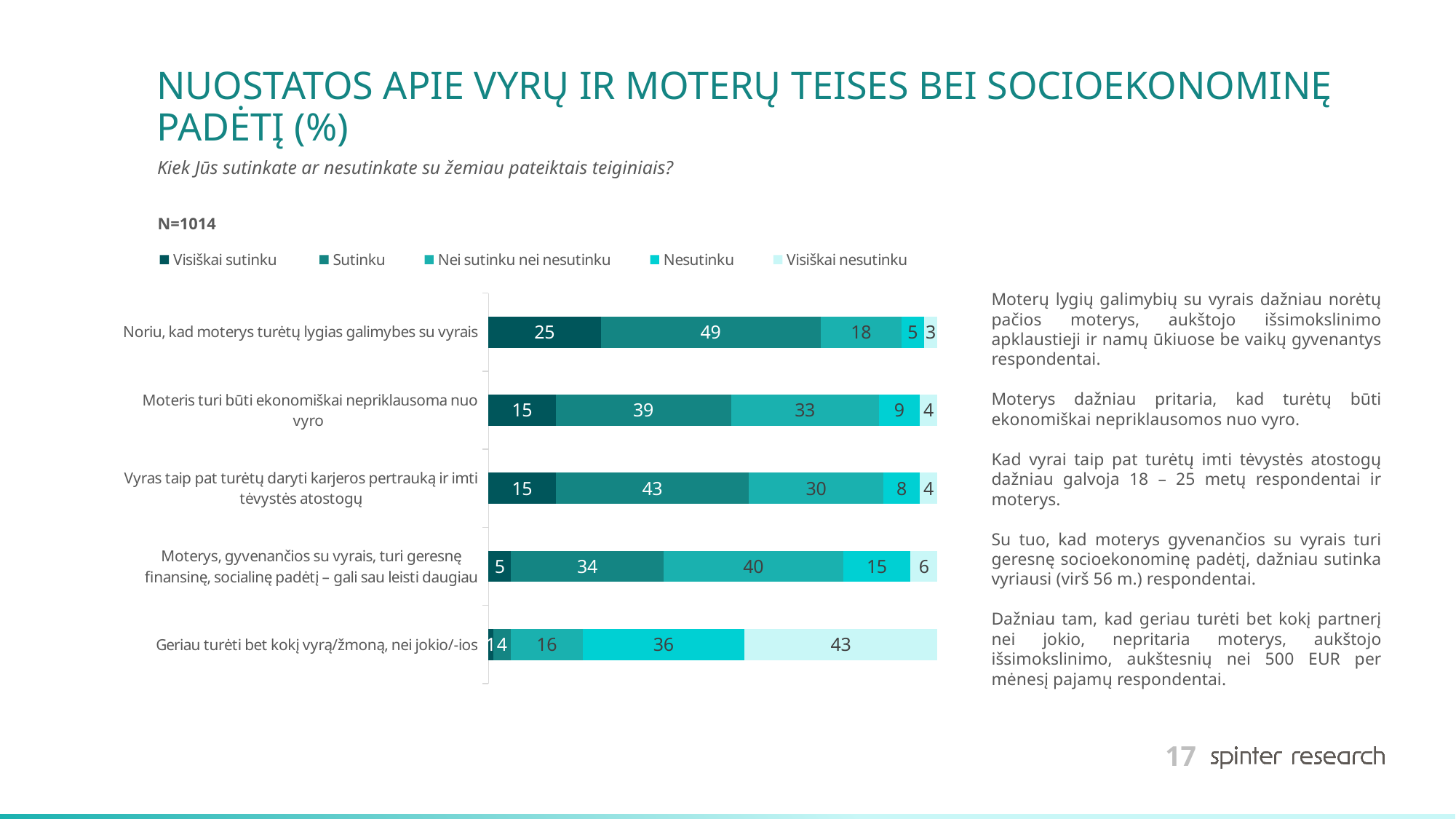
What is the value for "Nesutinku" for the statement "Moterys, gyvenančios su vyrais, turi geresnę finansinę, socialinę padėtį – gali sau leisti daugiau"? 15 What is the value for "Visiškai nesutinku" for the statement "Geriau turėti bet kokį vyrą/žmoną, nei jokio/-ios"? 43 What kind of chart is shown on the slide? Stacked bar chart How many statements are shown in the chart? 5 Which statement has the highest value for "Visiškai sutinku"? Noriu, kad moterys turėtų lygias galimybes su vyrais What is the value for "Sutinku" for the statement "Noriu, kad moterys turėtų lygias galimybes su vyrais"? 49 Which statement has the larger "Nei sutinku nei nesutinku" value: "Vyras taip pat turėtų daryti karjeros pertrauką ir imti tėvystės atostogų" or "Moterys, gyvenančios su vyrais, turi geresnę finansinę, socialinę padėtį – gali sau leisti daugiau"? Moterys, gyvenančios su vyrais, turi geresnę finansinę, socialinę padėtį – gali sau leisti daugiau What is the value for "Nei sutinku nei nesutinku" for the statement "Moteris turi būti ekonomiškai nepriklausoma nuo vyro"? 33 What is the sample size (N) shown on the slide? N=1014 What is the difference between the "Sutinku" values for "Noriu, kad moterys turėtų lygias galimybes su vyrais" and "Moteris turi būti ekonomiškai nepriklausoma nuo vyro"? 10 How many series does the legend list? 5 Which statement has the lowest value for "Visiškai nesutinku"? Noriu, kad moterys turėtų lygias galimybes su vyrais